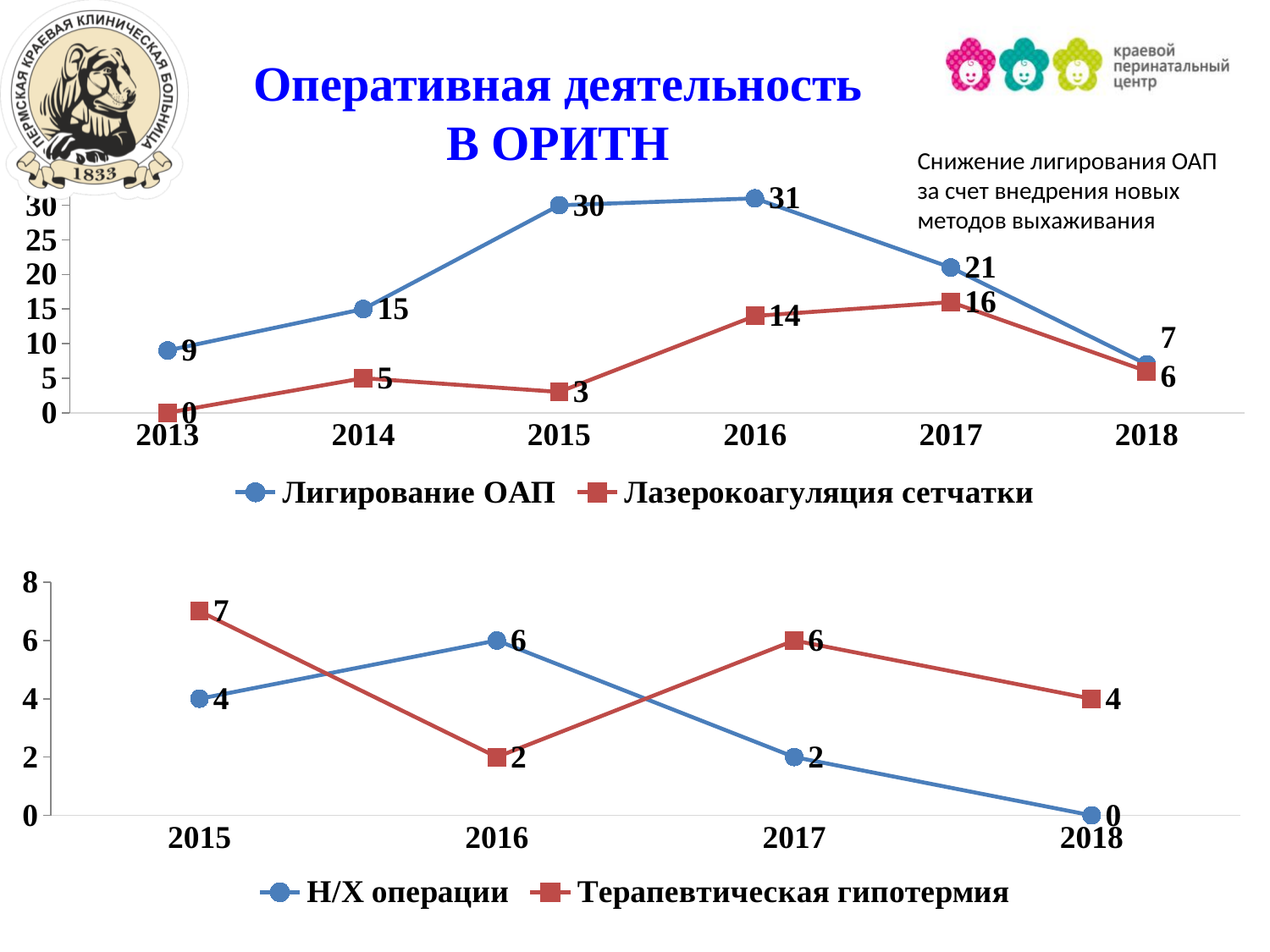
In the top chart, in which year is Лазерокоагуляция сетчатки lowest? 2013 In the top chart, what is the value for Лазерокоагуляция сетчатки in 2017? 16 In the top chart, how many years are shown on the x axis? 6 In the top chart, which series has the larger value in 2018? Лигирование ОАП In the bottom chart, how many series does the legend list? 2 What type of chart is the bottom chart? Line chart In the top chart, what is the value for Лигирование ОАП in 2016? 31 In the top chart, in which year is Лигирование ОАП highest? 2016 In the top chart, what is the difference between Лигирование ОАП and Лазерокоагуляция сетчатки in 2015? 27 In the bottom chart, how does Н/Х операции change from 2016 to 2018? It falls In the bottom chart, what is the value for Н/Х операции in 2018? 0 In the bottom chart, what is the value for Терапевтическая гипотермия in 2015? 7